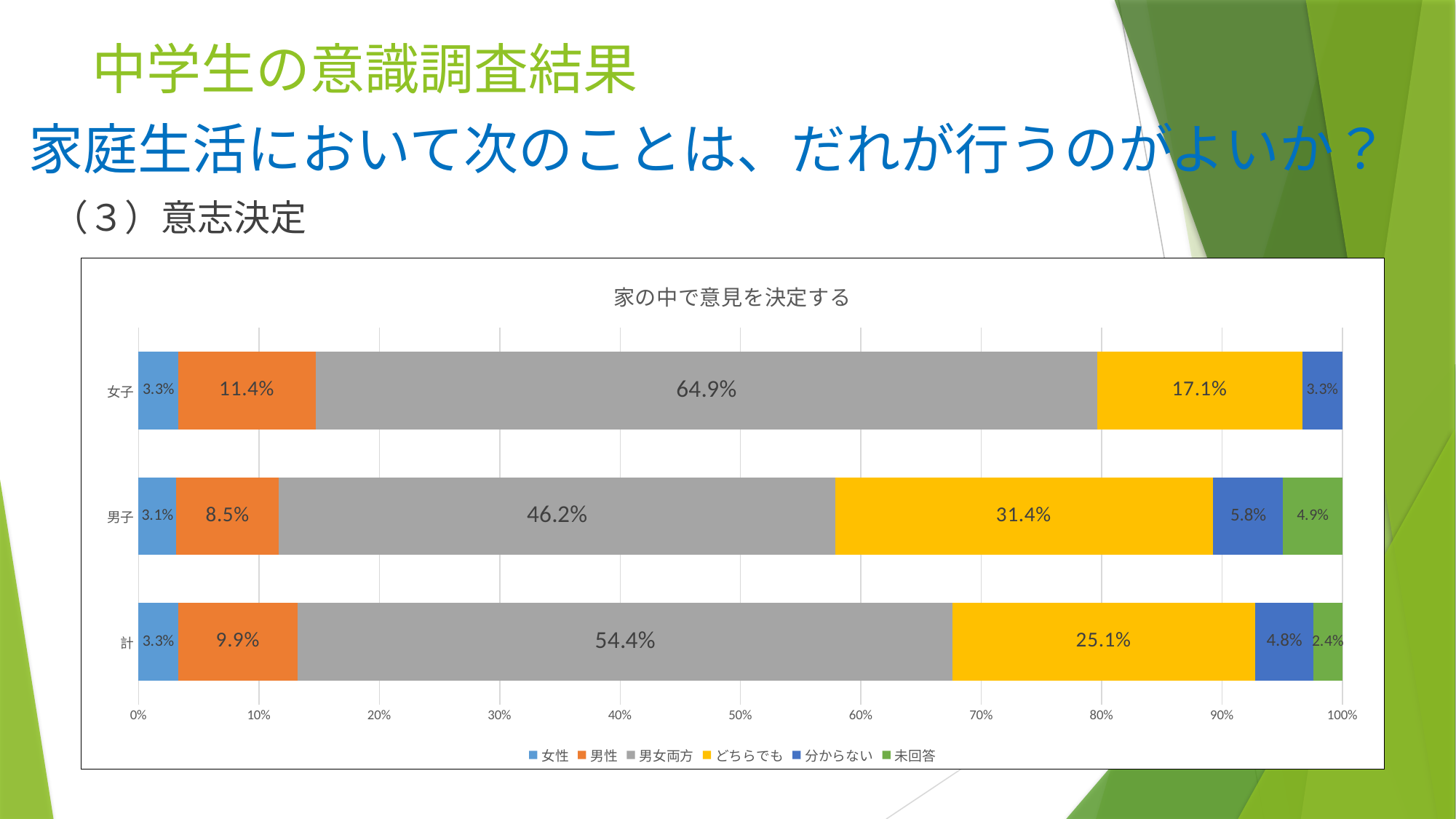
How many series does the legend list? 6 Which category has the lowest value for どちらでも? 女子 What is the difference between the 男女両方 values for 女子 and 男子? 18.7% How many categories (bars) are plotted in the chart? 3 What is the value of 男性 for 計? 9.9% What is the title of the chart? 家の中で意見を決定する What is the value of 男女両方 for 女子? 64.9% What is the value of どちらでも for 男子? 31.4% Which category has the highest value for 男女両方? 女子 Which is larger: the 分からない value for 男子 or for 計? 男子 What is the value of 未回答 for 男子? 4.9% What kind of chart is shown on the slide? Stacked bar chart